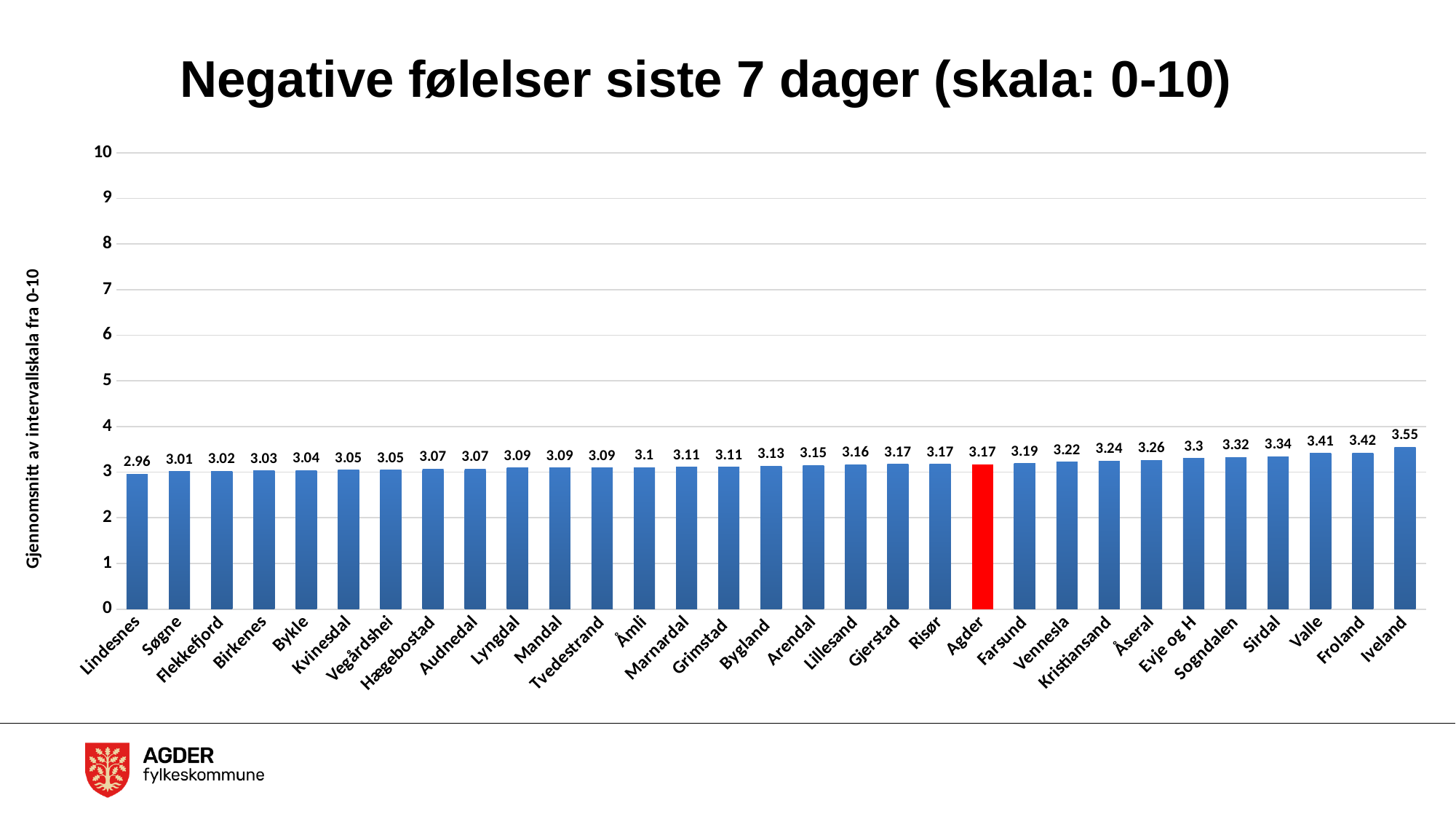
What is the value for Agder? 3.17 Do the values rise or fall from left to right along the x axis? rise What is the value for Kristiansand? 3.24 Which category has the lowest value? Lindesnes Which is larger, the value for Froland or the value for Farsund? Froland Which category has the highest value? Iveland What kind of chart is this? bar chart How many categories are shown on the x axis? 31 Which bar is coloured red instead of blue? Agder What is the value for Lindesnes? 2.96 What is the difference between the values for Iveland and Lindesnes? 0.59 Is the value for Valle greater or less than 4? less